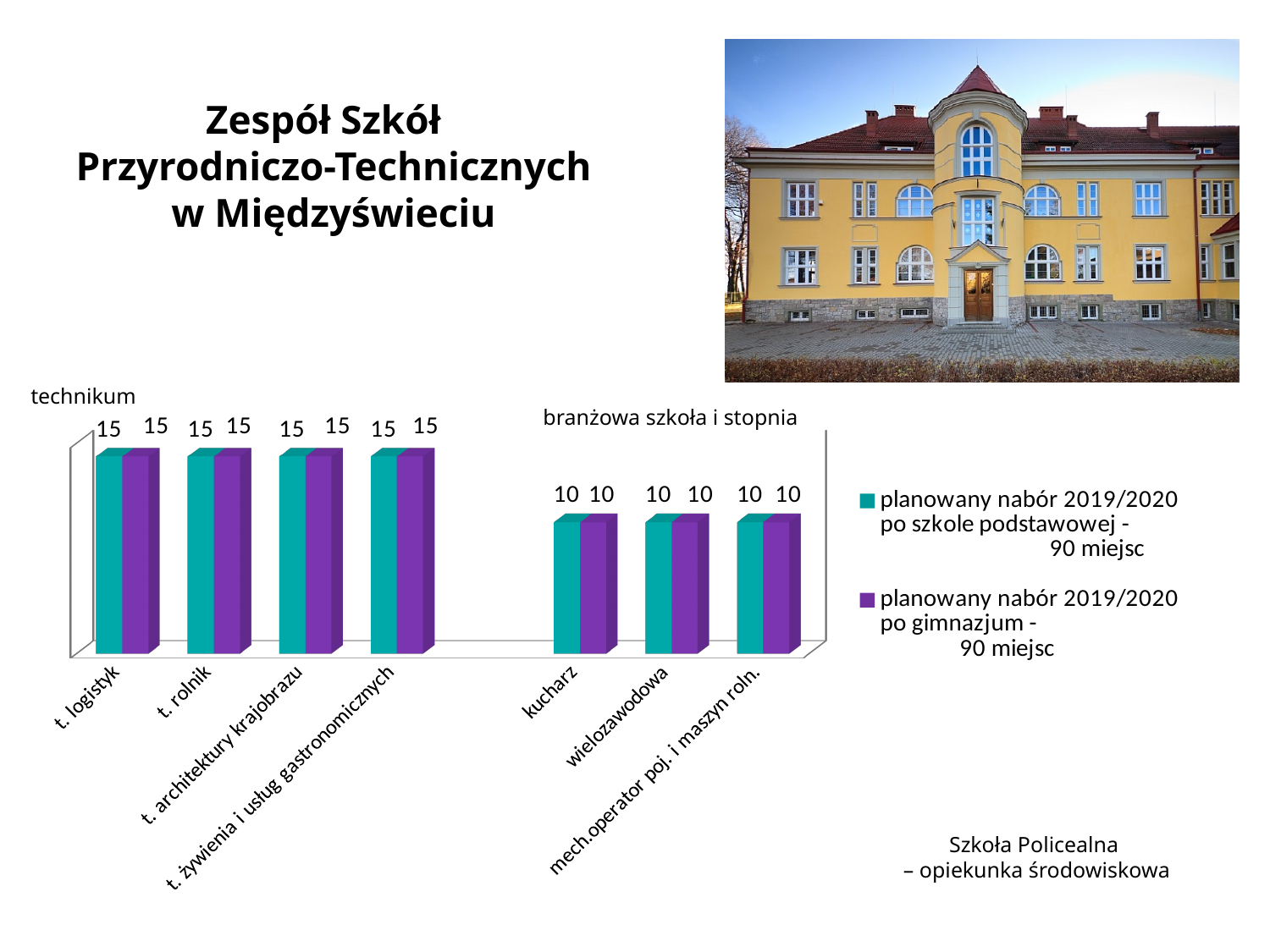
What is the value for t. logistyk in the 'planowany nabór 2019/2020 po szkole podstawowej' series? 15 How many categories are shown on the x axis of the chart? 7 What is the total of the two series values for t. żywienia i usług gastronomicznych? 30 What is the difference between the 'po szkole podstawowej' values for t. rolnik and kucharz? 5 Which is larger in the 'po gimnazjum' series: t. architektury krajobrazu or mech.operator poj. i maszyn roln.? t. architektury krajobrazu Which colour represents the 'planowany nabór 2019/2020 po gimnazjum' series? purple What is the value for wielozawodowa in the 'planowany nabór 2019/2020 po szkole podstawowej' series? 10 Which group label appears above the three categories on the right side of the chart? branżowa szkoła i stopnia What kind of chart is shown on the slide? bar chart What is the value for kucharz in the 'planowany nabór 2019/2020 po gimnazjum' series? 10 How many series does the chart legend list? 2 What is the value for t. rolnik in the 'planowany nabór 2019/2020 po gimnazjum' series? 15